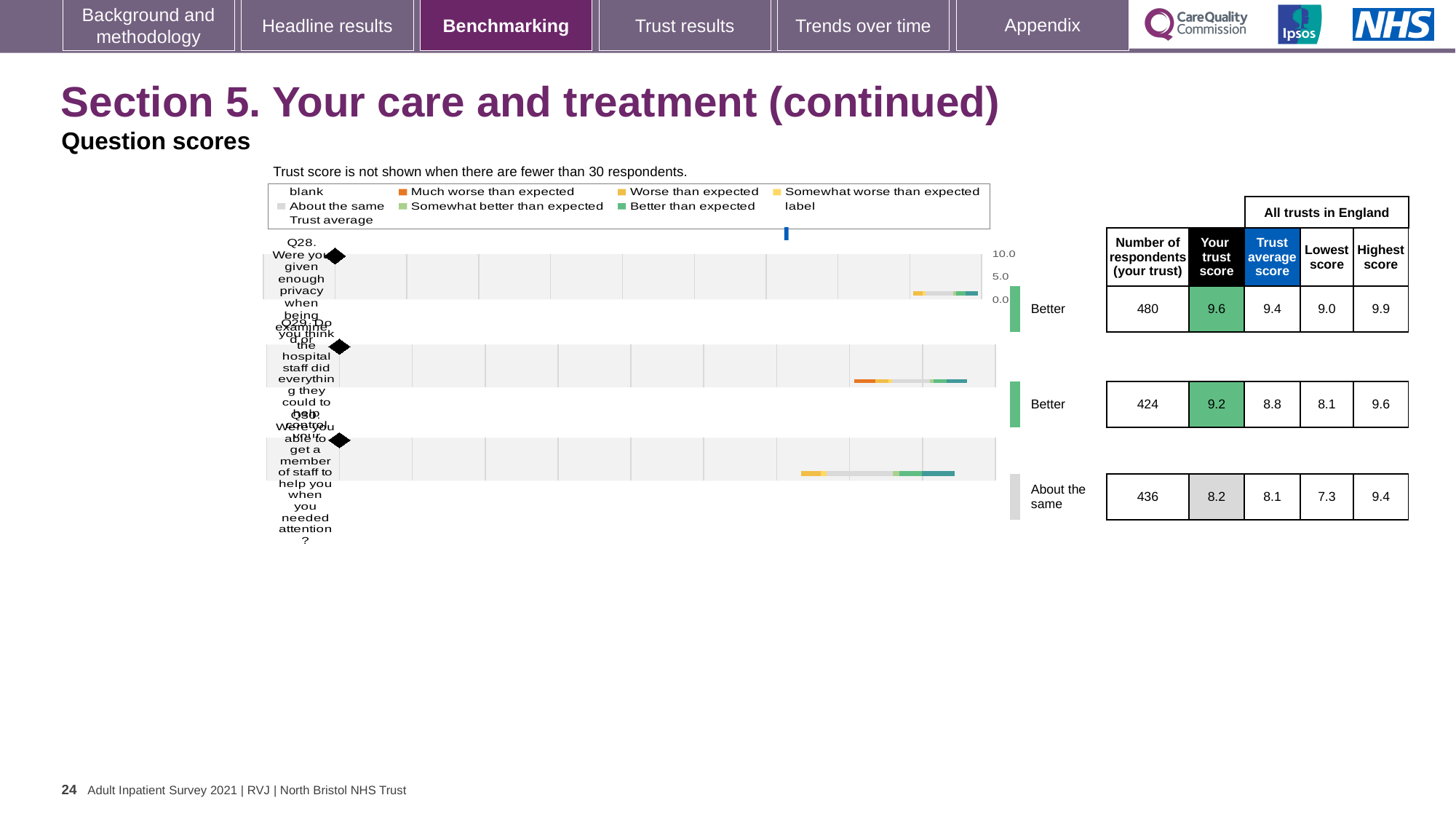
Which of the three questions shown has the highest trust score? Q28 How many questions are plotted in the chart? 3 How many respondents answered Q30 at this trust? 436 What is the trust average score across all trusts in England for Q29? 8.8 What is the difference between the trust score and the trust average score for Q28? 0.2 What benchmark category is shown for Q30? About the same Which of the three questions shown has the lowest trust score? Q30 What is the trust score for Q28 (Were you given enough privacy when being examined or treated)? 9.6 Is the trust score for Q29 higher or lower than the trust average score for Q29? higher What is the trust score for Q30 (Were you able to get a member of staff to help you when you needed attention)? 8.2 What is the difference between the highest score and the lowest score for Q30? 2.1 What is the trust score for Q29 (Do you think the hospital staff did everything they could to help control your pain)? 9.2